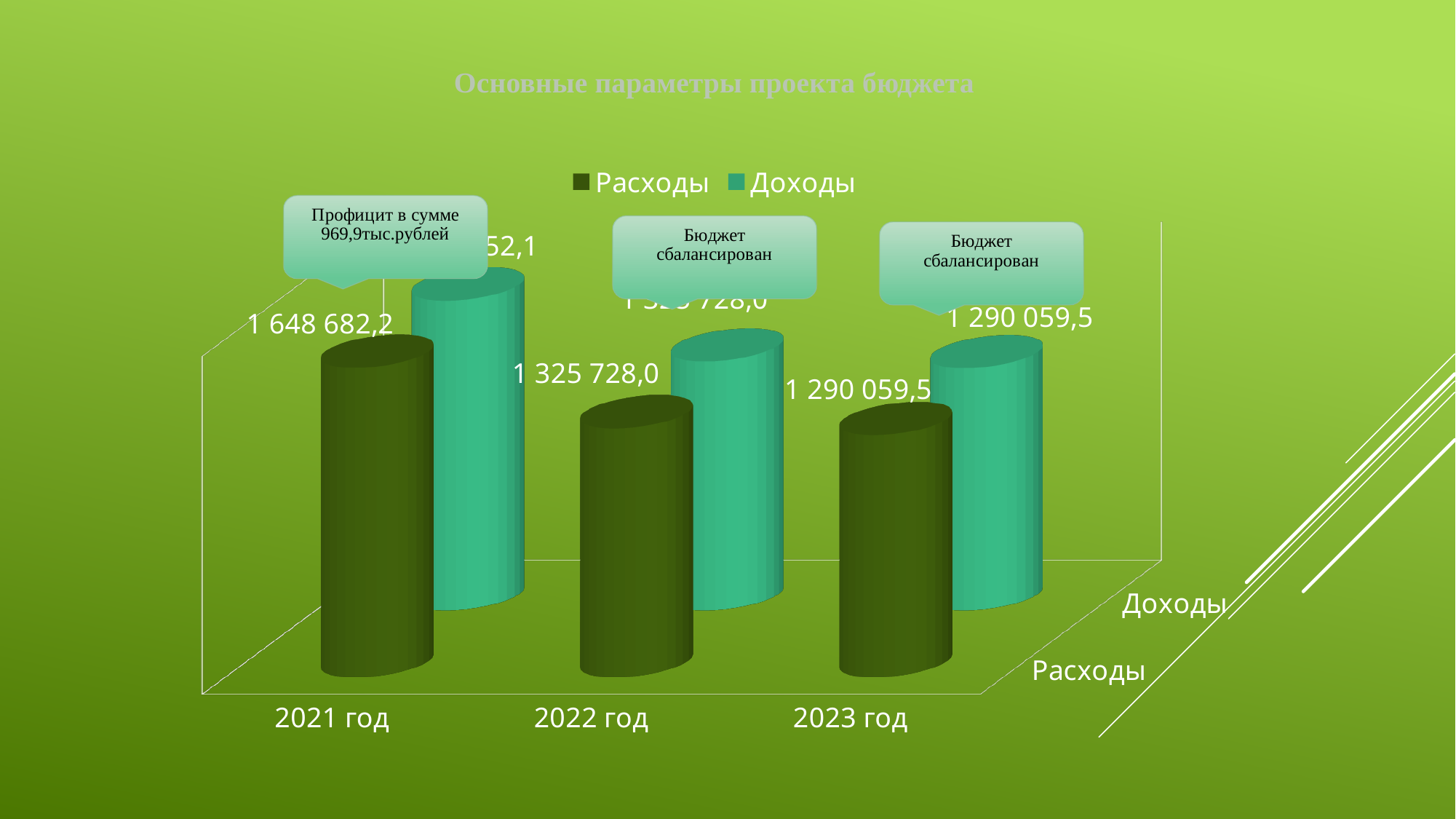
How many years (categories) are shown on the x axis? 3 What is the value of Доходы for 2023 год? 1 290 059,5 In which year is Расходы the highest? 2021 год What is the value of Расходы for 2021 год? 1 648 682,2 Do the Расходы values rise or fall from 2021 год to 2023 год? Fall What kind of chart is shown on the slide? Bar chart In which year is Расходы the lowest? 2023 год What is the title of the chart? Основные параметры проекта бюджета What is the value of Расходы for 2023 год? 1 290 059,5 What is the value of Расходы for 2022 год? 1 325 728,0 What is the difference between Расходы in 2021 год and 2022 год? 322 954,2 How many series does the legend list? 2